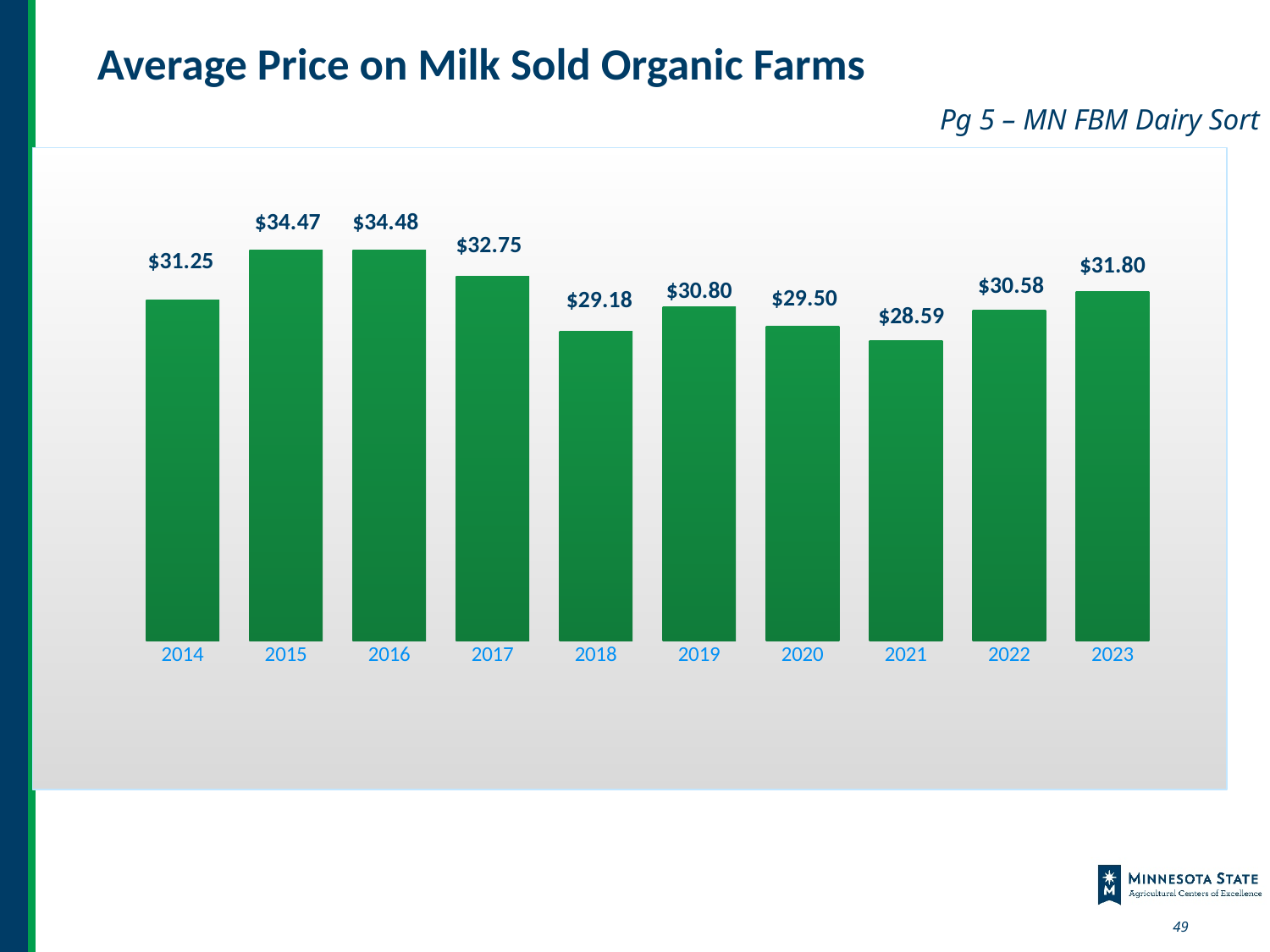
How much higher is the 2017 price than the 2018 price? $3.57 Which year has a higher average milk price, 2018 or 2020? 2020 What is the average milk price shown for 2014? $31.25 What is the average price on milk sold for organic farms in 2019? $30.80 What is the difference between the 2023 value and the 2022 value? $1.22 Which year has the lowest average price on milk sold? 2021 Do the values rise or fall from 2021 to 2023? Rise What is the title of the chart on the slide? Average Price on Milk Sold Organic Farms Which year has a higher value, 2014 or 2017? 2017 What kind of chart is shown on the slide? Bar chart What value is shown for 2021 in the chart? $28.59 How many years are shown in the chart? 10